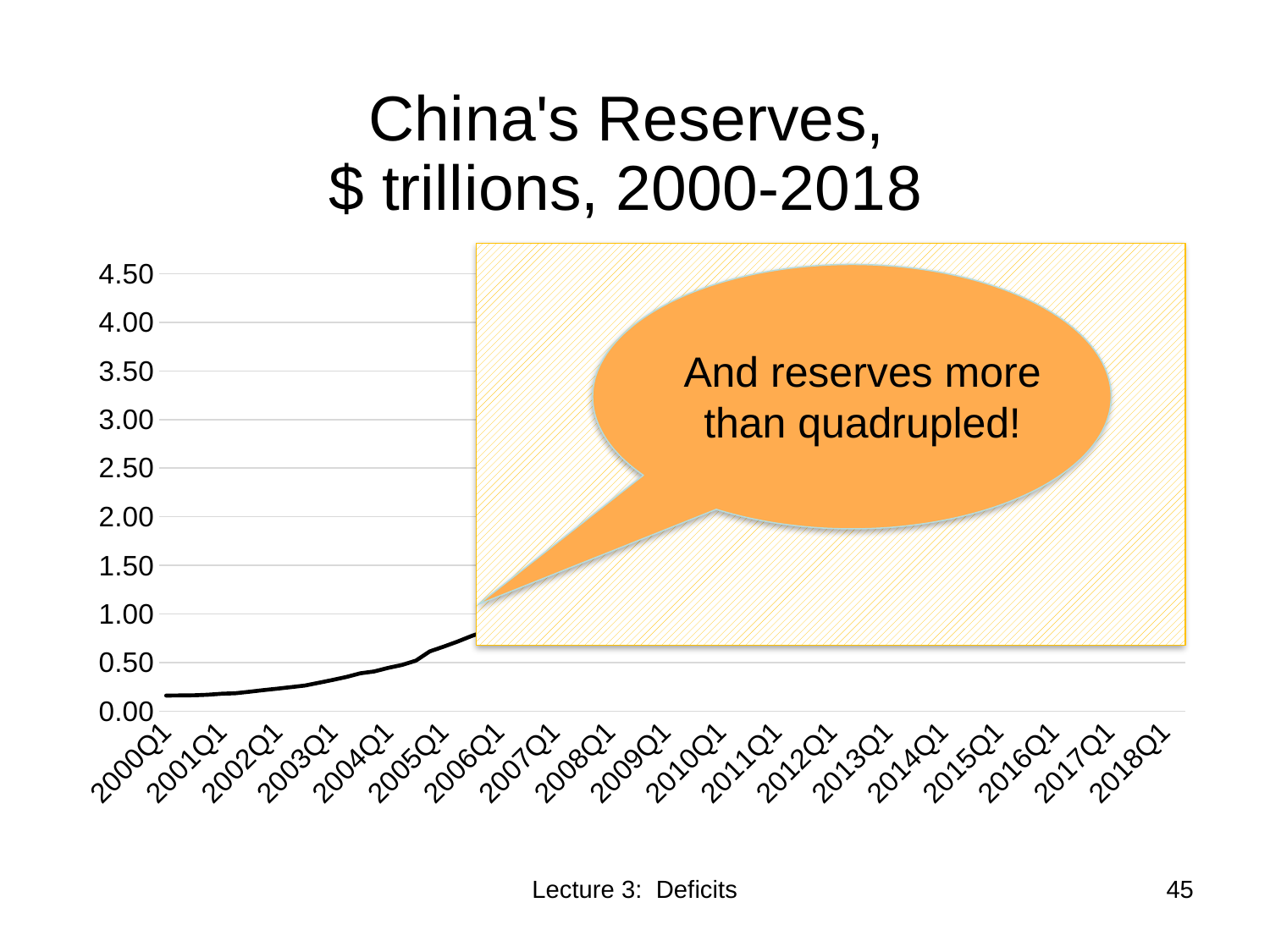
Which is larger, the value for 2005Q1 or the value for 2000Q1? 2005Q1 Is the value for 2002Q1 greater or less than 1.00? less What does the callout on the chart say? And reserves more than quadrupled! What kind of chart is shown on the slide? line chart How many year labels are shown on the x axis? 19 Is the value for 2000Q1 greater or less than 0.50? less What is the highest tick value shown on the y axis? 4.50 What is the title of the chart? China's Reserves, $ trillions, 2000-2018 Is the value for 2003Q1 greater or less than 0.50? less Do the values rise or fall along the x axis from 2000Q1 to 2005Q1? rise Which is larger, the value for 2001Q1 or the value for 2004Q1? 2004Q1